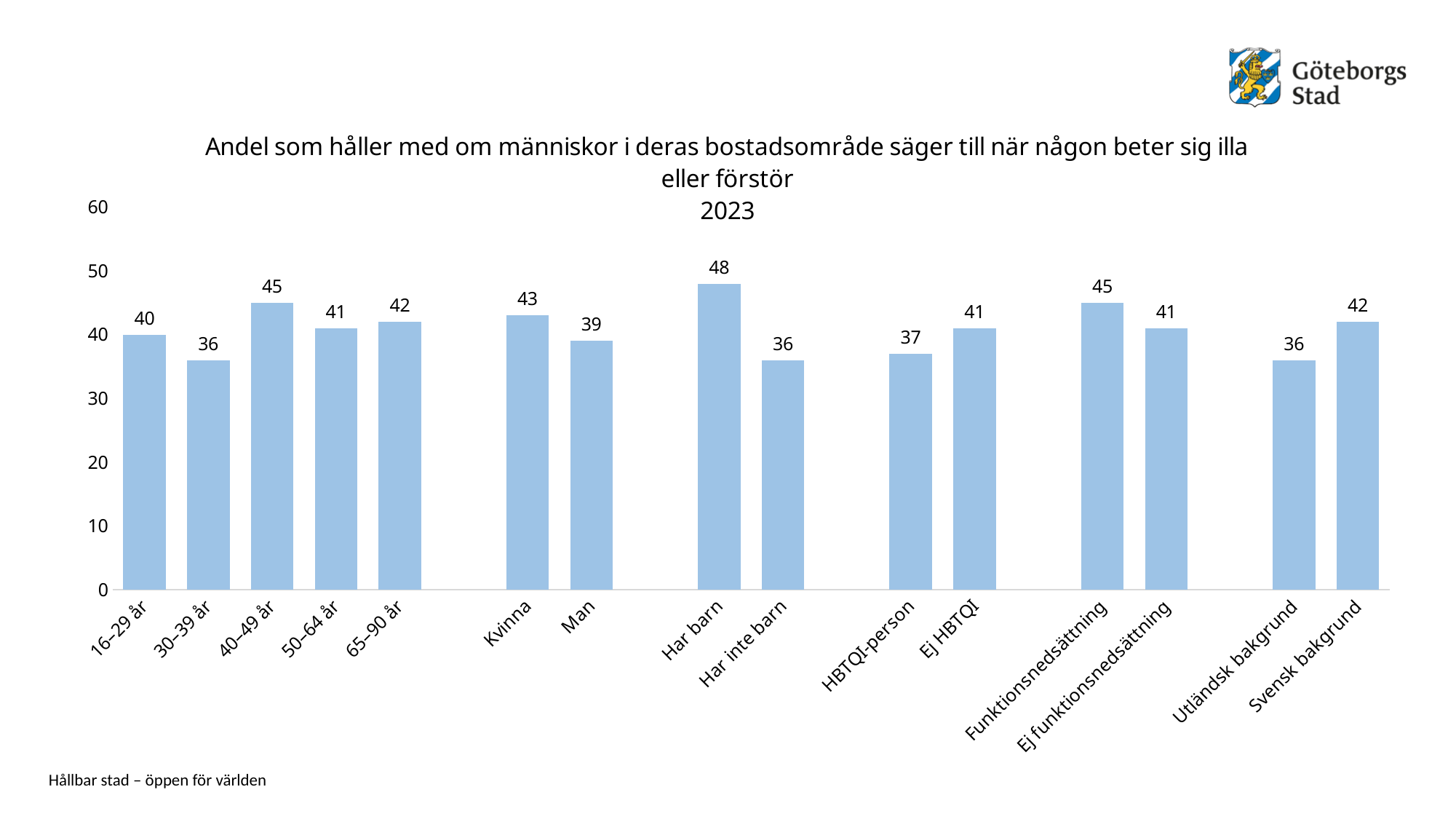
Which category has the highest value? Har barn Which is larger, the value for Utländsk bakgrund or Svensk bakgrund? Svensk bakgrund What is the value for Kvinna? 43 What kind of chart is shown on the slide? Bar chart What is the difference between the values for Kvinna and Man? 4 What is the difference between the values for Har barn and Har inte barn? 12 What is the value for HBTQI-person? 37 How many categories are shown on the chart? 15 What year is shown in the chart title? 2023 What is the value for 30–39 år? 36 What is the value for Har barn? 48 Which is larger, the value for Funktionsnedsättning or Ej funktionsnedsättning? Funktionsnedsättning